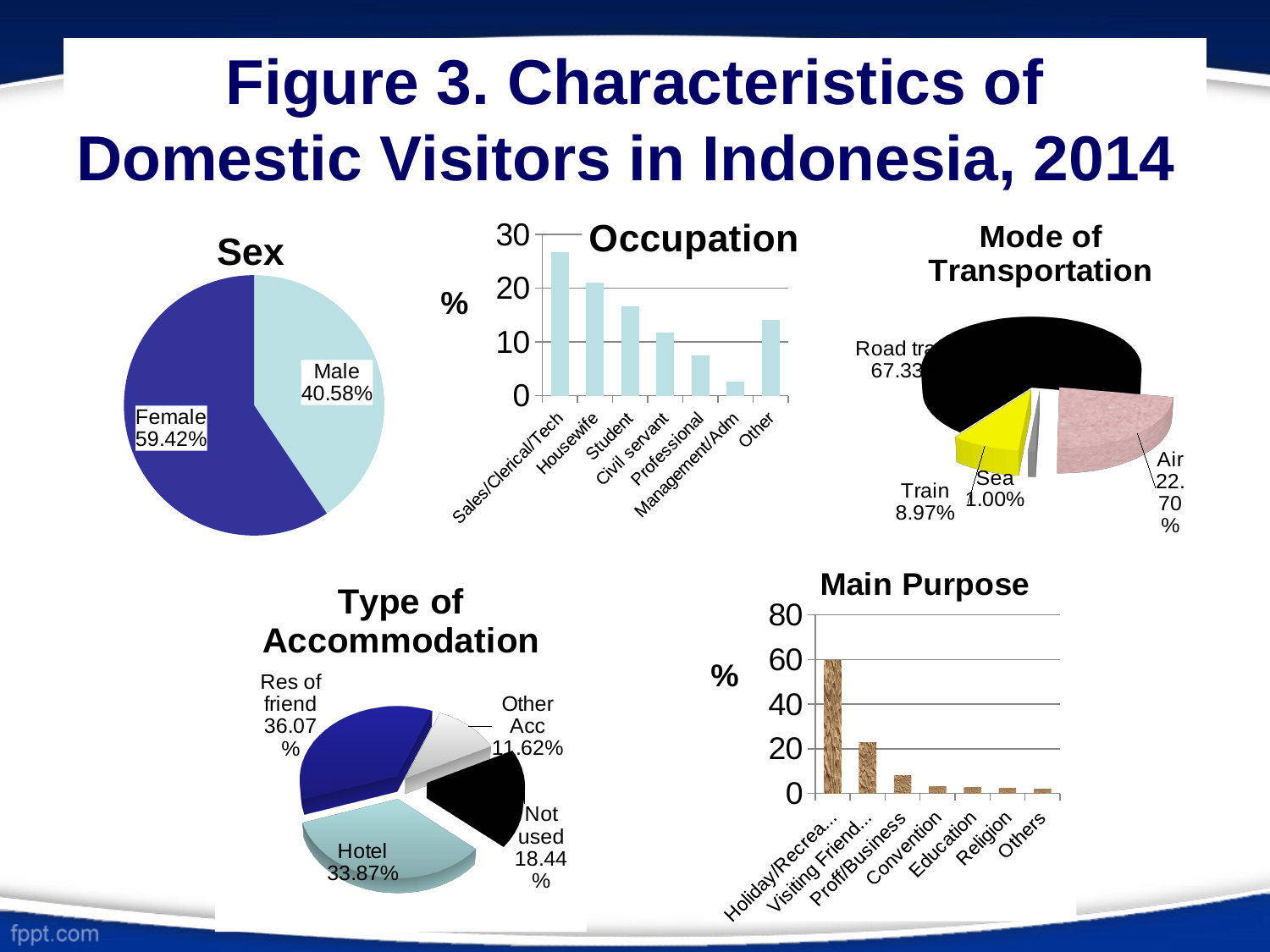
In the Mode of Transportation pie chart, which mode has the smallest share? Sea In the Main Purpose chart, is the value for Holiday/Recreation greater or less than 40? greater In the Sex pie chart, what percentage of domestic visitors are female? 59.42% What kind of chart is the Occupation chart? bar chart In the Occupation chart, is the value for Professional greater or less than 10? less In the Type of Accommodation pie chart, which type has the largest share? Res of friend In the Type of Accommodation pie chart, what is the difference in percentage points between Hotel and Not used? 15.43 In the Occupation chart, which occupation has the highest value? Sales/Clerical/Tech How many occupation categories are shown in the Occupation chart? 7 In the Mode of Transportation pie chart, what percentage of visitors travelled by Air? 22.70% In the Sex pie chart, what is the difference in percentage points between Female and Male? 18.84 In the Occupation chart, which occupation has the lowest value? Management/Adm